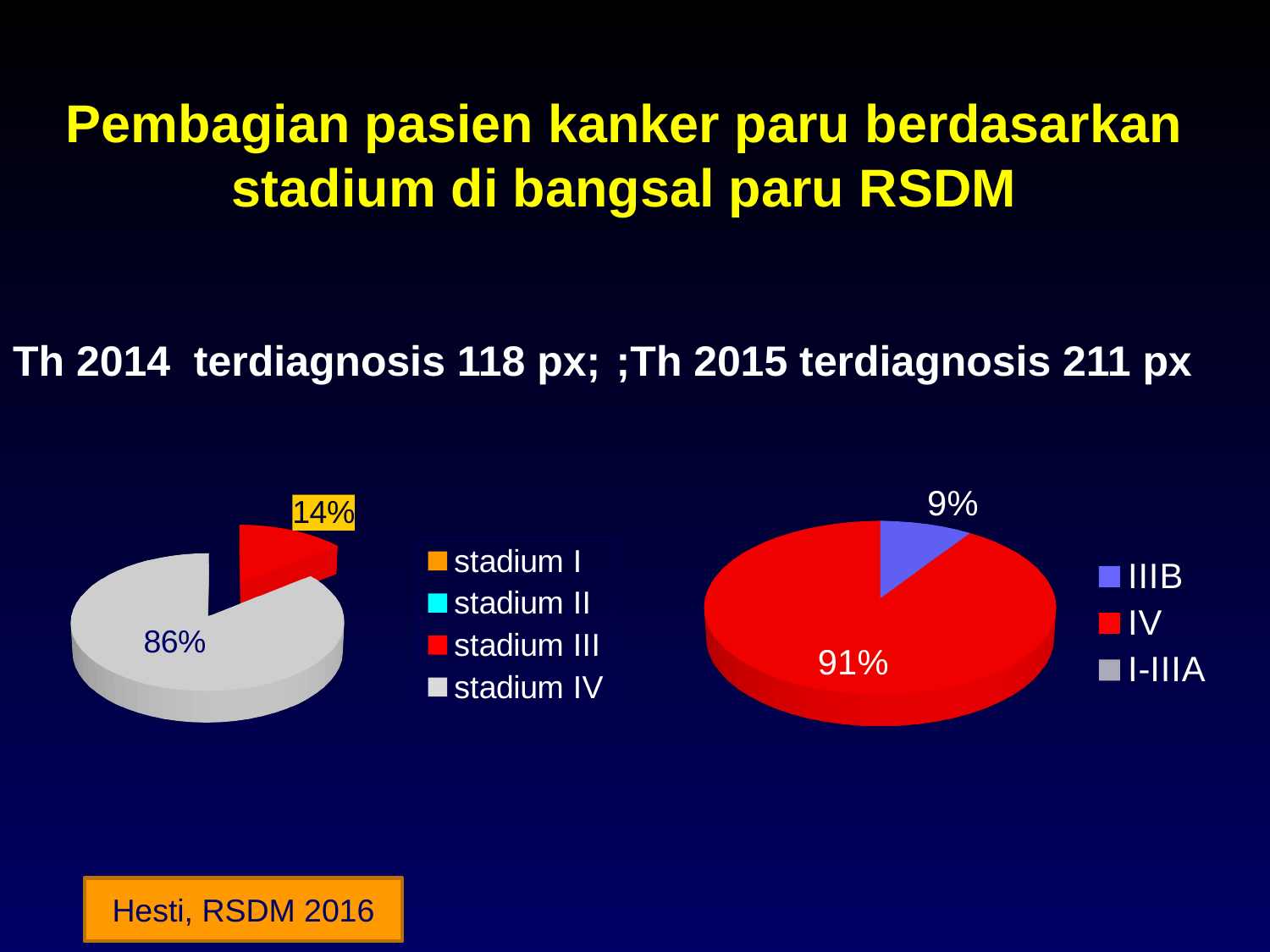
On the right pie chart, what percentage is shown for IIIB? 9% On the right pie chart, what is the difference between the IV and IIIB percentages? 82% How many entries does the legend of the left pie chart list? 4 On the right pie chart, which is larger, IIIB or IV? IV On the right pie chart, what percentage is shown for IV? 91% What type of chart is shown on the right side of the slide? Pie chart On the left pie chart, what is the difference between the 86% slice and the 14% slice? 72% On the right pie chart, which category has the smallest visible slice? IIIB On the right pie chart, which category has the largest slice? IV On the left pie chart, what percentage is shown for stadium IV? 86% On the left pie chart, what percentage is shown on the red slice? 14% On the left pie chart, which legend category has the largest slice? stadium IV